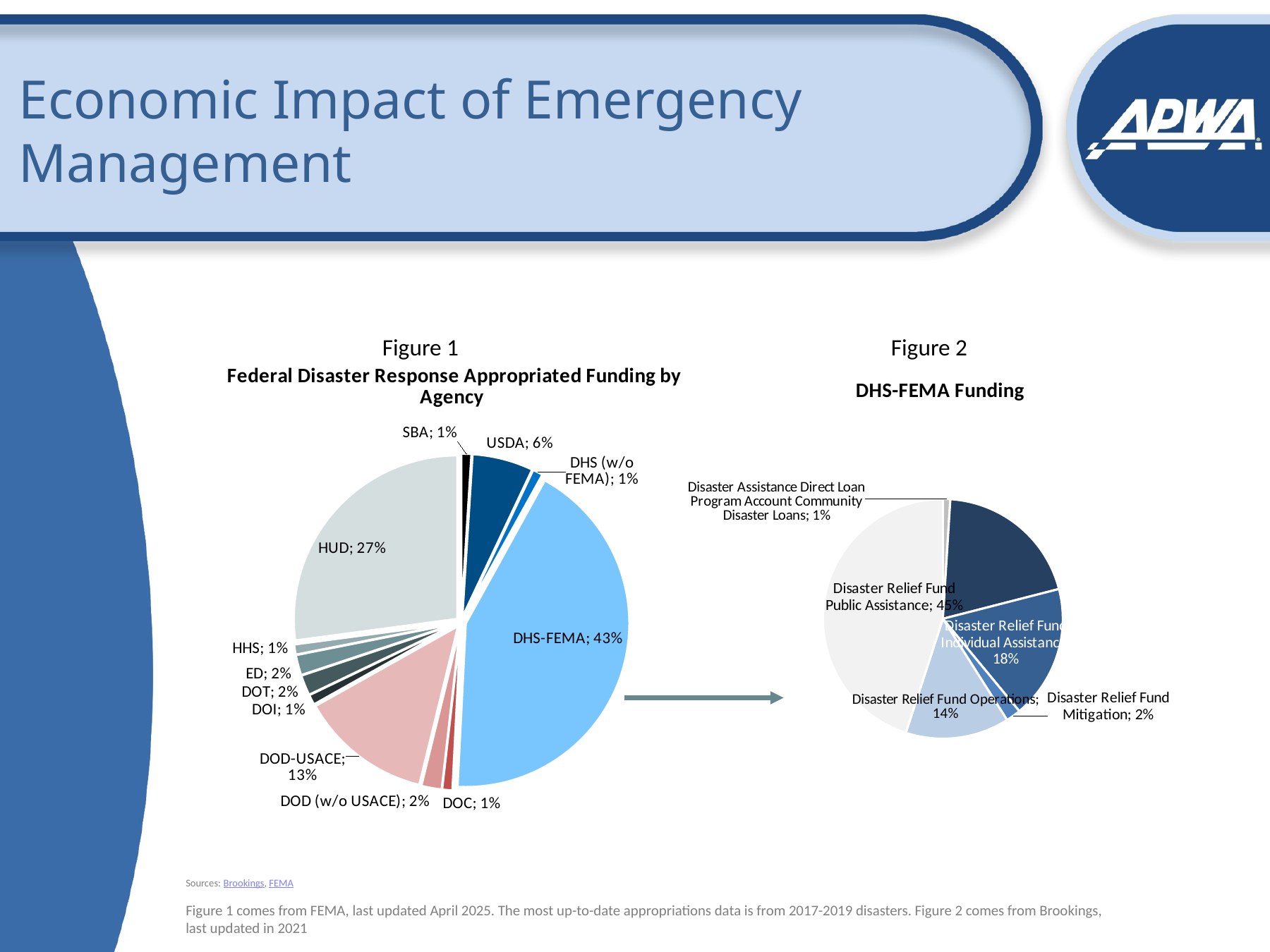
What kind of chart is Figure 1, Federal Disaster Response Appropriated Funding by Agency? Pie chart In Figure 2, DHS-FEMA Funding, what percentage is shown for Disaster Relief Fund Public Assistance? 45% In Figure 1, what percentage is shown for HUD? 27% In Figure 1, what share of federal disaster response appropriated funding goes to DHS-FEMA? 43% In Figure 1, what is the difference in percentage points between DHS-FEMA and HUD? 16 What is the title of the chart in Figure 2? DHS-FEMA Funding In Figure 2, which is larger, Disaster Relief Fund Individual Assistance or Disaster Relief Fund Mitigation? Disaster Relief Fund Individual Assistance In Figure 1, what percentage is shown for DOD-USACE? 13% In Figure 1, which agency has the largest share of funding? DHS-FEMA In Figure 1, which is larger, the share for USDA or the share for DOD-USACE? DOD-USACE How many agency slices are labeled in Figure 1? 12 In Figure 2, DHS-FEMA Funding, what percentage is shown for Disaster Relief Fund Operations? 14%